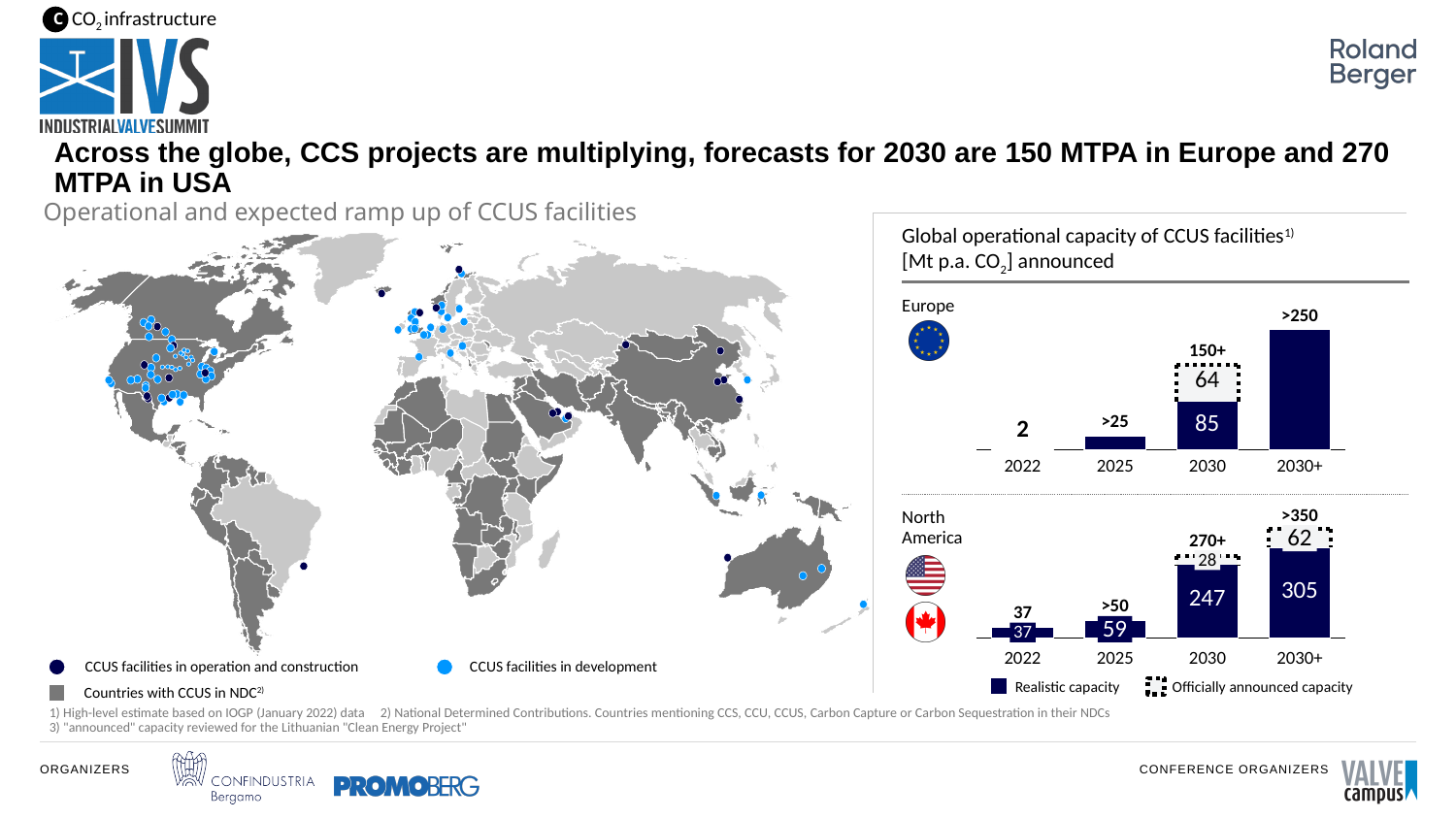
In the North America chart, what is the difference between the realistic capacity for 2030+ and for 2030? 58 In the North America chart, what is the realistic capacity shown for 2030+? 305 In the Europe chart, what is the total of the 2030 stacked bar (realistic plus officially announced)? 149 In the North America chart, what is the officially announced capacity shown for 2030? 28 In the North America chart, which year has the lowest value? 2022 In the Europe chart, what is the officially announced capacity shown for 2030? 64 In the Europe chart, do the values rise or fall from 2022 to 2030+? rise How many series does the legend below the charts list? 2 In the Europe chart, what value is shown for 2022? 2 In the Europe chart, what total is labelled above the 2030+ bar? >250 In the North America chart, what is the realistic capacity shown for 2025? 59 In the Europe chart, what is the realistic capacity shown for 2030? 85